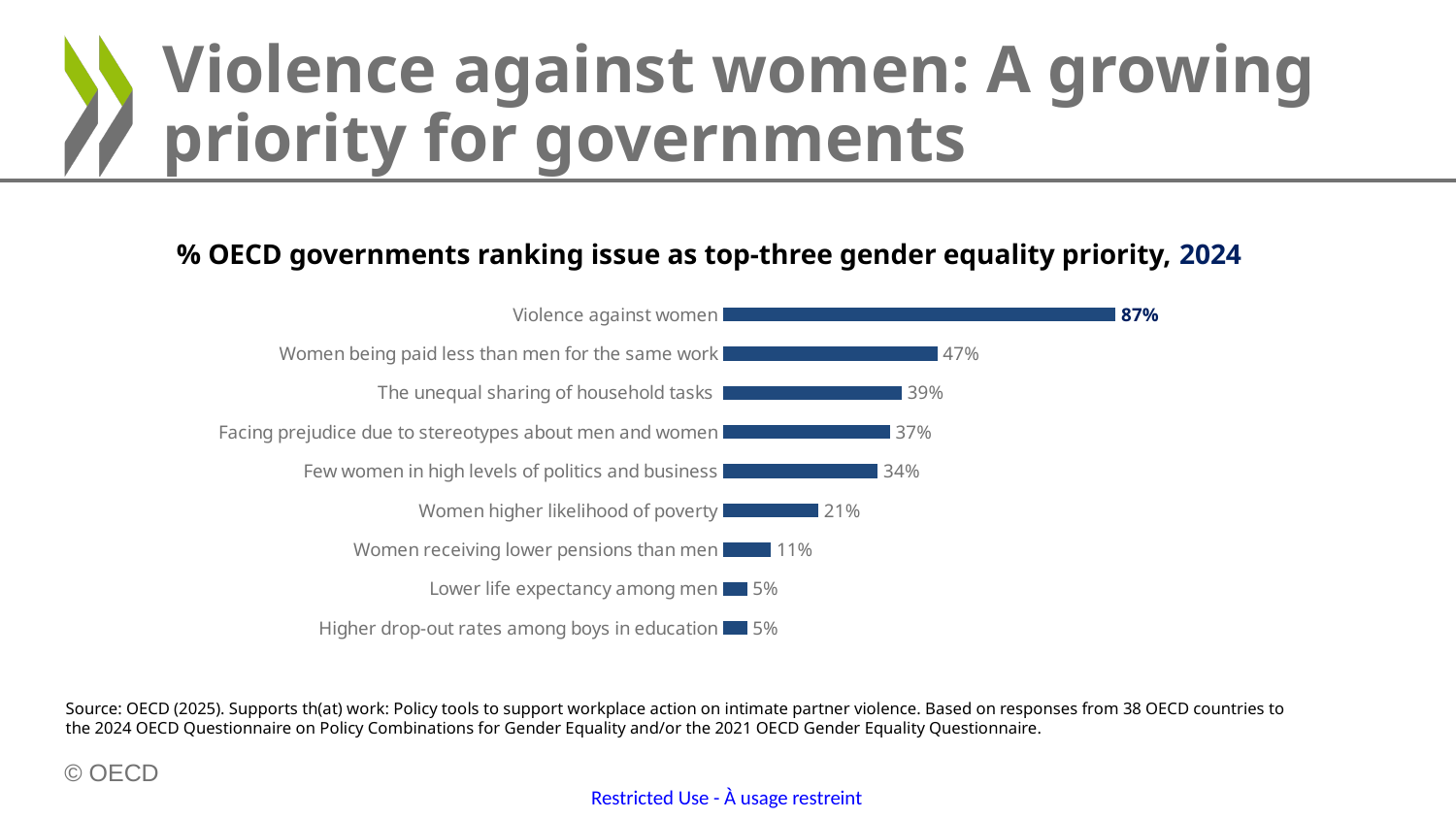
What year is referenced in the chart title? 2024 What is the difference between the values for 'Violence against women' and 'Women being paid less than men for the same work'? 40 percentage points What is the value for 'Women receiving lower pensions than men'? 11% How many issues (categories) are shown in the chart? 9 Which issue has the highest share of governments ranking it as a top-three priority? Violence against women Which two issues share the lowest value of 5%? Lower life expectancy among men; Higher drop-out rates among boys in education What is the value for 'Women being paid less than men for the same work'? 47% What type of chart is shown on the slide? Bar chart What is the value for 'Few women in high levels of politics and business'? 34% Which is larger: the value for 'The unequal sharing of household tasks' or 'Facing prejudice due to stereotypes about men and women'? The unequal sharing of household tasks What is the difference between 'The unequal sharing of household tasks' and 'Women higher likelihood of poverty'? 18 percentage points What percentage of OECD governments ranked violence against women as a top-three gender equality priority? 87%